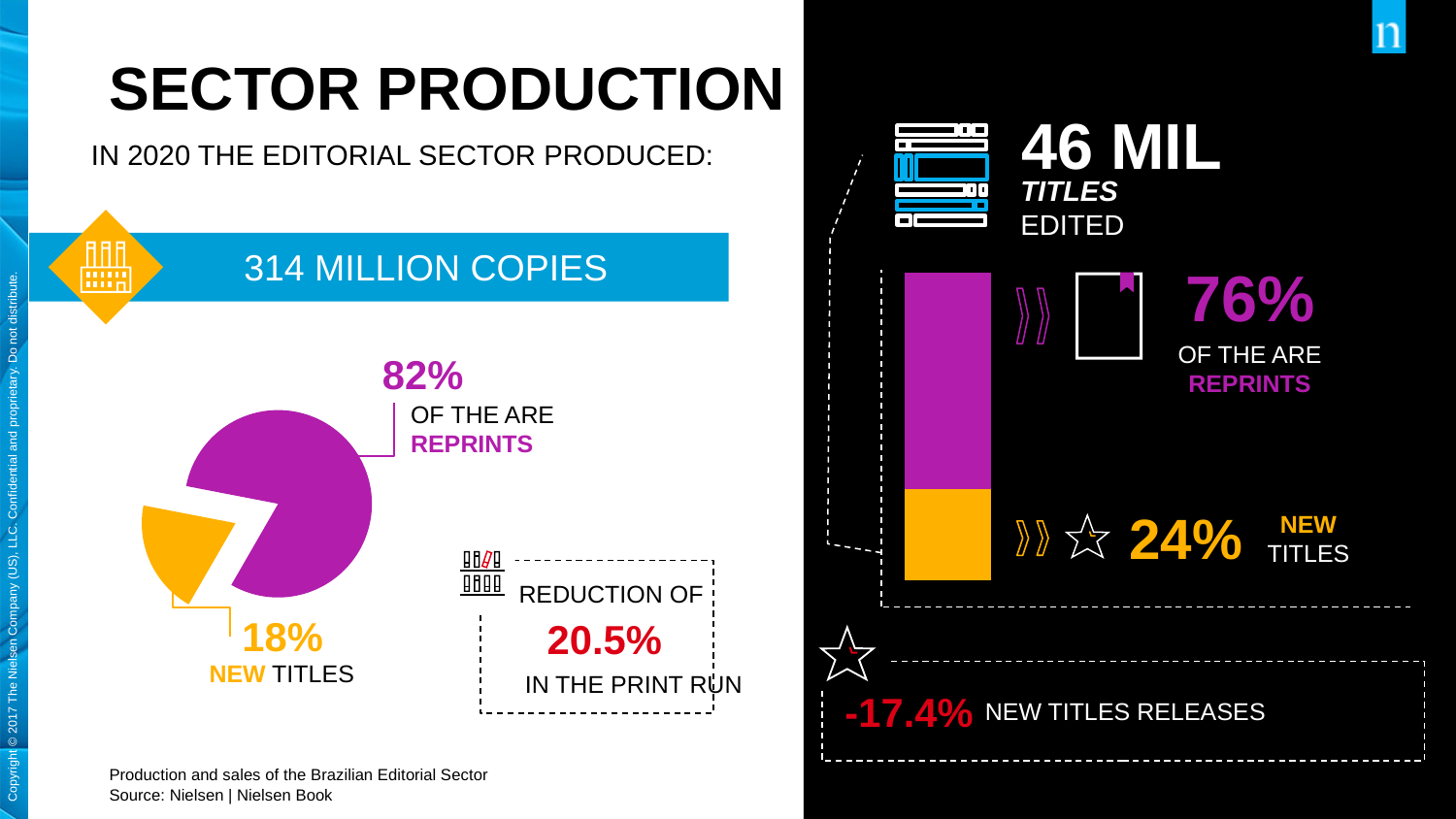
In the pie chart on the left of the slide, what share of the copies are reprints? 82% In the pie chart on the left of the slide, what colour is the new titles slice? Yellow In the stacked bar on the right of the slide, which segment is larger, reprints or new titles? Reprints What kind of chart is shown on the left of the slide under '314 MILLION COPIES'? Pie chart In the stacked bar on the right of the slide, what percentage of the titles edited are reprints? 76% How many slices does the pie chart on the left of the slide have? 2 In the stacked bar on the right of the slide, what percentage of the titles edited are new titles? 24% In the pie chart on the left of the slide, what is the difference in percentage points between the reprints share and the new titles share? 64 percentage points In the pie chart on the left of the slide, which slice is larger, reprints or new titles? Reprints In the pie chart on the left of the slide, what share of the copies are new titles? 18% In the stacked bar on the right of the slide, what is the total of the two segments (76% and 24%)? 100% In the stacked bar on the right of the slide, what colour is the reprints segment? Purple